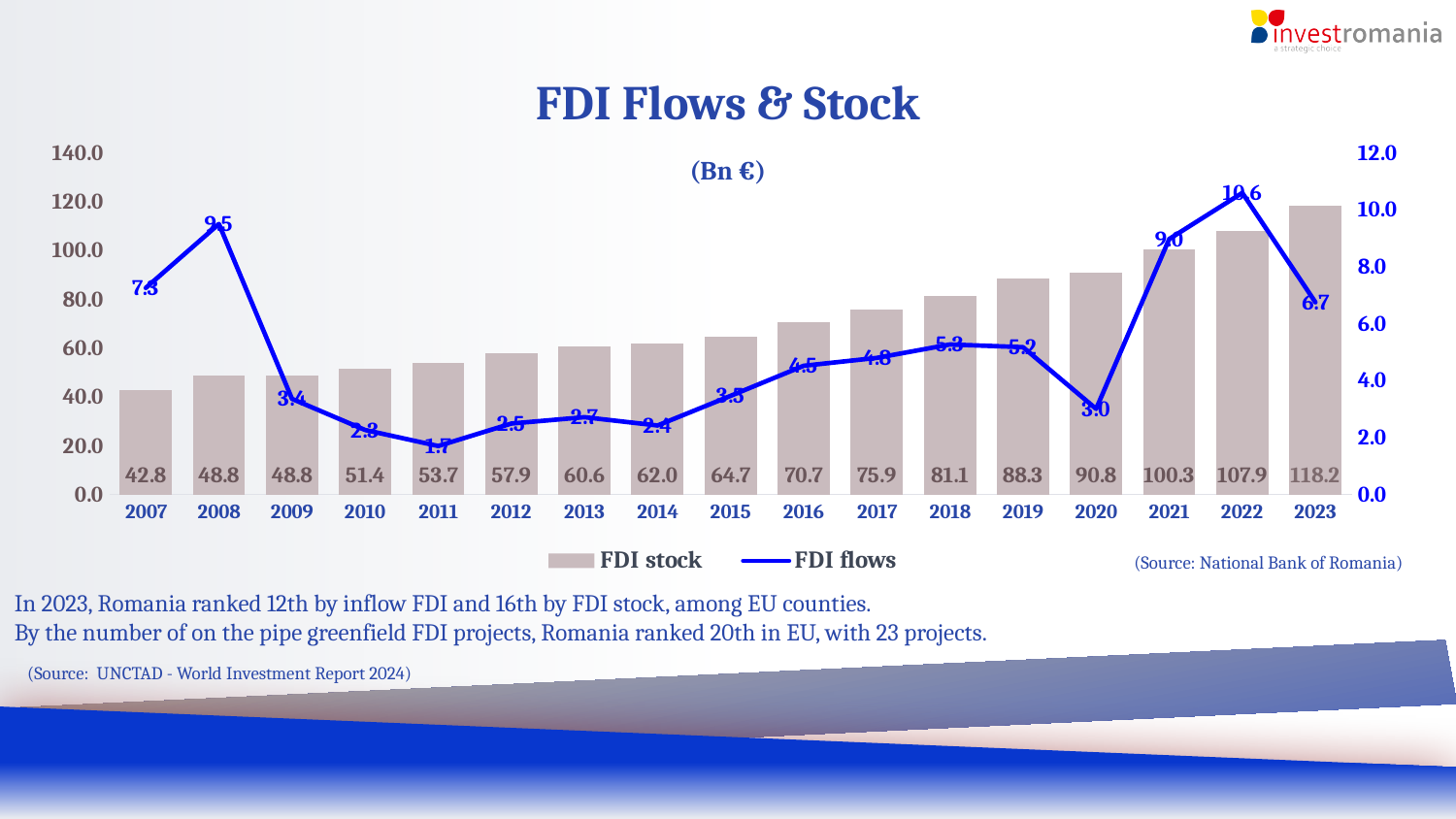
How many years are shown on the x axis? 17 What is the FDI flows value for 2008? 9.5 Does the FDI stock rise or fall from 2007 to 2023? Rises What is the difference between the FDI stock in 2023 and in 2022? 10.3 What is the FDI stock value for 2015? 64.7 Which year has the highest FDI stock? 2023 What kind of chart is shown on the slide? Combined bar and line chart What is the FDI stock value for 2023? 118.2 Which is larger, the FDI flows value for 2016 or for 2019? 2019 How many series does the legend list? 2 Which year has the highest FDI flows value? 2022 Which year has the lowest FDI flows value? 2011